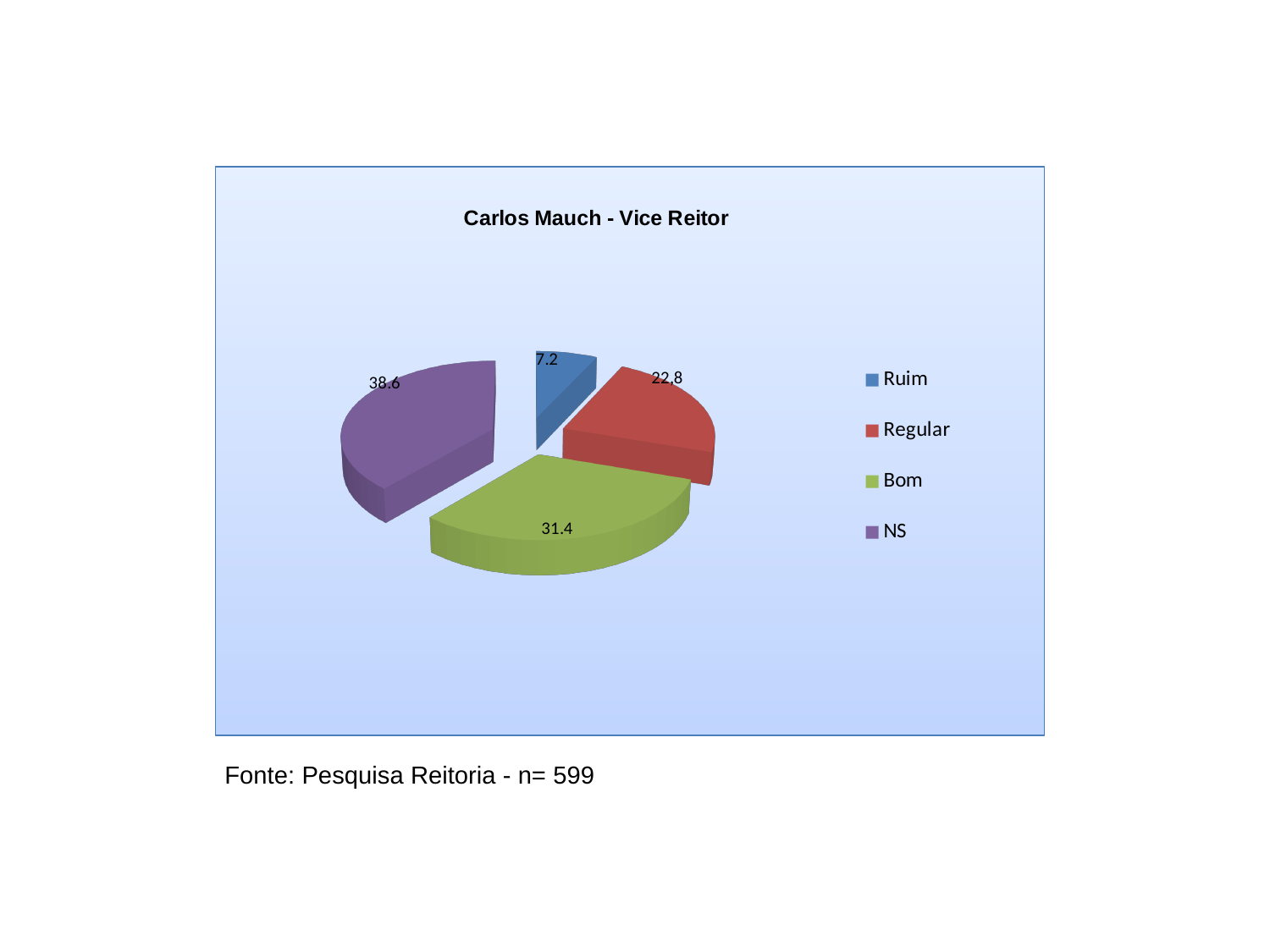
Which colour represents the NS category in the legend? Purple What is the title of the chart? Carlos Mauch - Vice Reitor What is the value shown for the Bom slice? 31.4 What kind of chart is shown on the slide? Pie chart Which is larger, the value for Bom or the value for Regular? Bom What is the value shown for the Regular slice? 22,8 Which category has the largest slice of the pie? NS What is the value shown for the Ruim slice? 7.2 What is the value shown for the NS slice? 38.6 What is the difference between the NS value and the Bom value? 7.2 How many slices does the pie chart have? 4 Which category has the smallest slice of the pie? Ruim